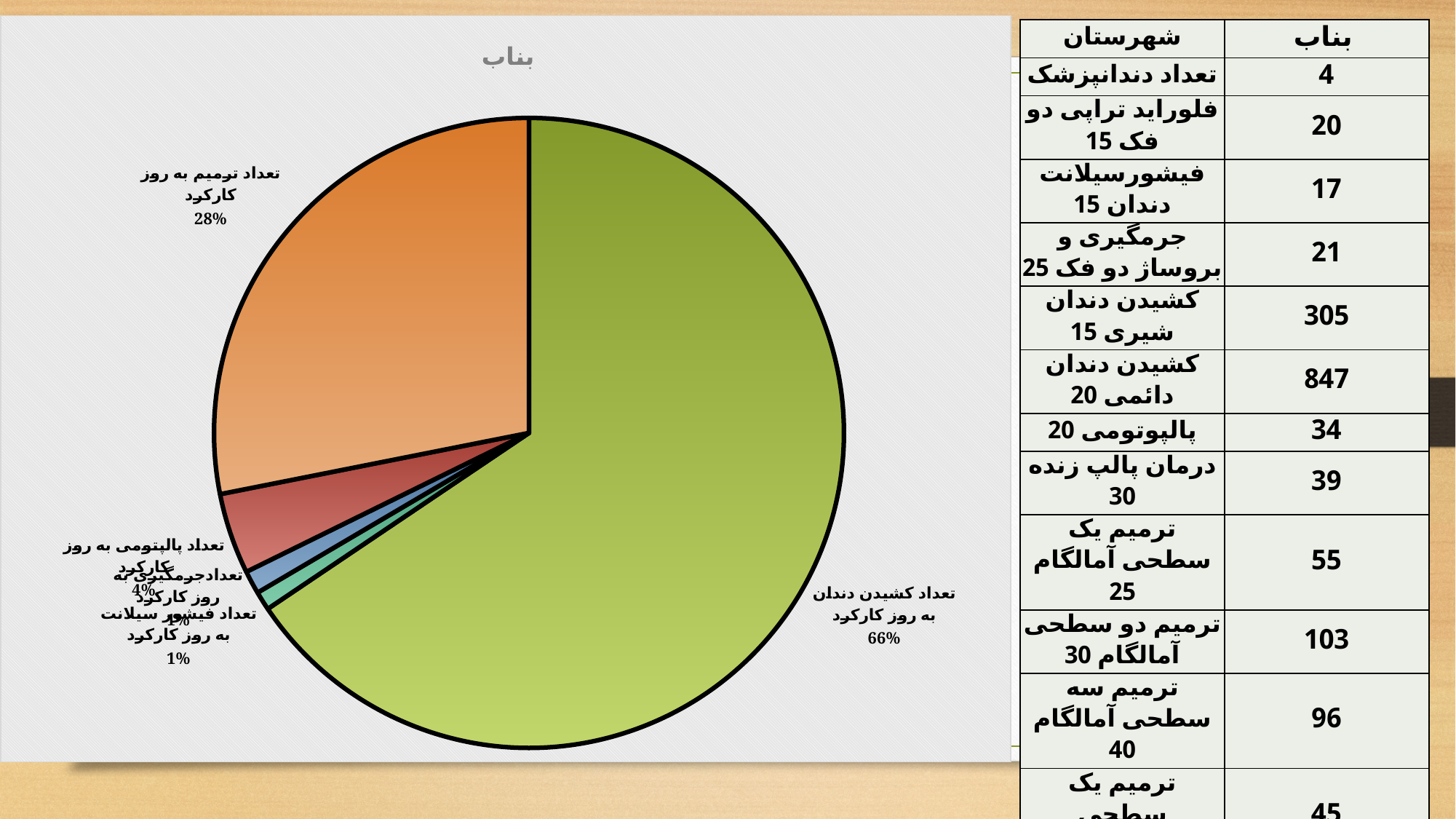
Is the share for "تعداد کشیدن دندان به روز کارکرد" greater or less than 50%? greater What share of the pie does "تعداد کشیدن دندان به روز کارکرد" have? 66% What colour is the largest slice of the pie chart? green Which is larger, the share for "تعداد ترمیم به روز کارکرد" or the share for "تعداد پالپوتومی به روز کارکرد"? تعداد ترمیم به روز کارکرد What is the difference in percentage points between the share for "تعداد کشیدن دندان به روز کارکرد" and the share for "تعداد ترمیم به روز کارکرد"? 38 What share of the pie does "تعداد فیشور سیلانت به روز کارکرد" have? 1% What share of the pie does "تعداد ترمیم به روز کارکرد" have? 28% What kind of chart is shown on the slide? pie chart What is the title of the pie chart? بناب How many slices does the pie chart have? 5 Which category has the largest share of the pie? تعداد کشیدن دندان به روز کارکرد